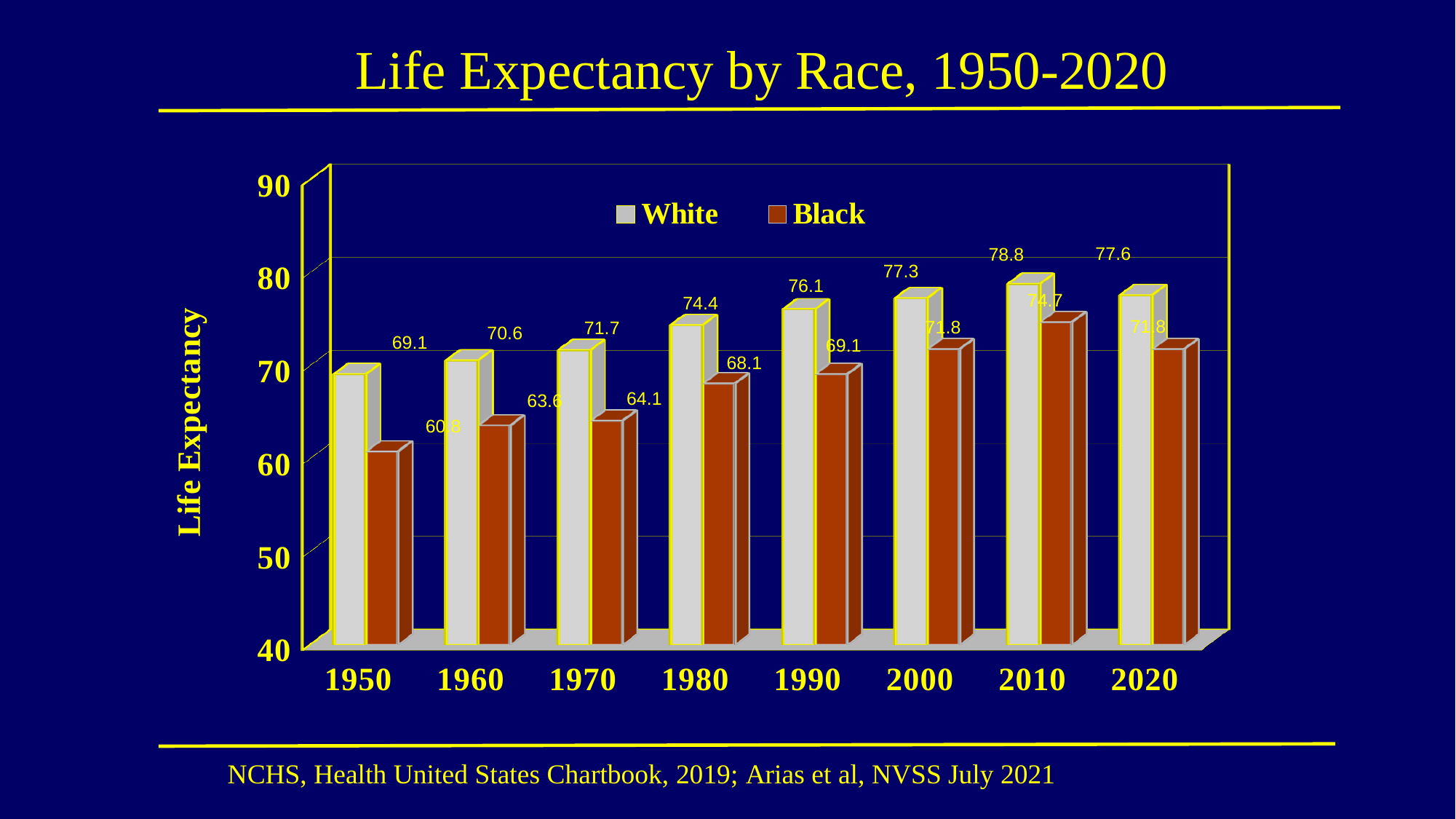
In which year is the White life expectancy highest? 2010 How many years are shown on the x axis? 8 Which is larger: the White life expectancy in 1970 or the Black life expectancy in 1980? White in 1970 What is the difference between the White and Black life expectancy in 2000? 5.5 What is the life expectancy for White in 2020? 77.6 What is the life expectancy for White in 1980? 74.4 What is the life expectancy for Black in 1990? 69.1 What kind of chart is shown on the slide? bar chart In which year is the Black life expectancy lowest? 1950 Is the Black life expectancy in 1960 greater or less than 70? less How many series does the legend list? 2 Does the White life expectancy rise or fall from 1950 to 2010? rise